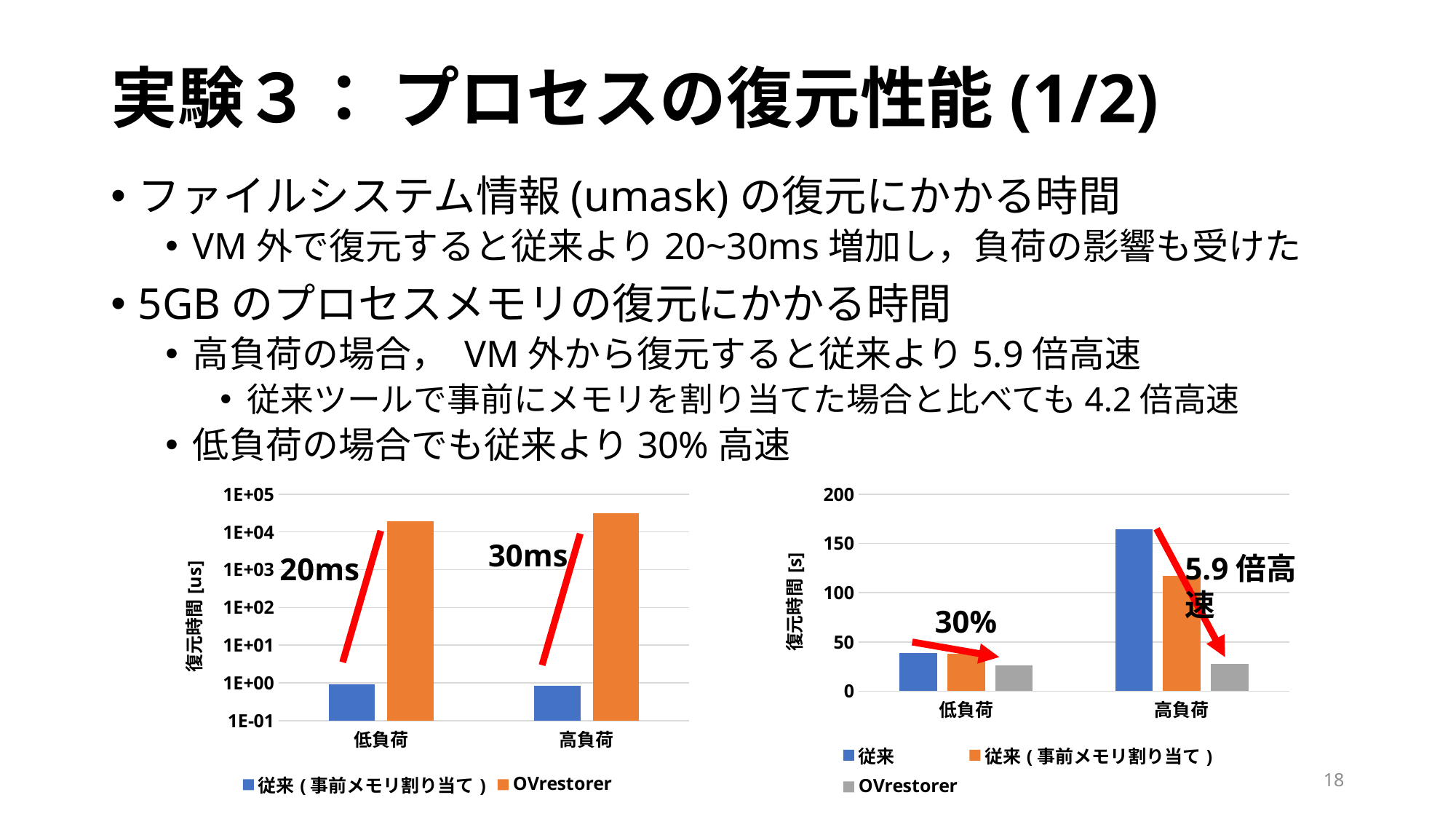
How many series does the legend of the right chart (復元時間 [s]) list? 3 How many series does the legend of the left chart (復元時間 [us]) list? 2 How many categories are shown on the x axis of the right chart (復元時間 [s])? 2 What is the y-axis label of the right chart? 復元時間 [s] In the left chart (復元時間 [us]), is the value for OVrestorer at 低負荷 greater or less than 1E+03? greater What kind of chart is the left chart (復元時間 [us])? bar chart In the left chart (復元時間 [us]), which is larger at 高負荷: 従来 ( 事前メモリ割り当て ) or OVrestorer? OVrestorer In the right chart (復元時間 [s]), which is larger at 高負荷: 従来 or OVrestorer? 従来 In the right chart (復元時間 [s]), which series has the highest bar at 高負荷? 従来 In the right chart (復元時間 [s]), is the value for OVrestorer at 高負荷 greater or less than 50? less In the right chart (復元時間 [s]), is the value for 従来 ( 事前メモリ割り当て ) at 高負荷 greater or less than 100? greater